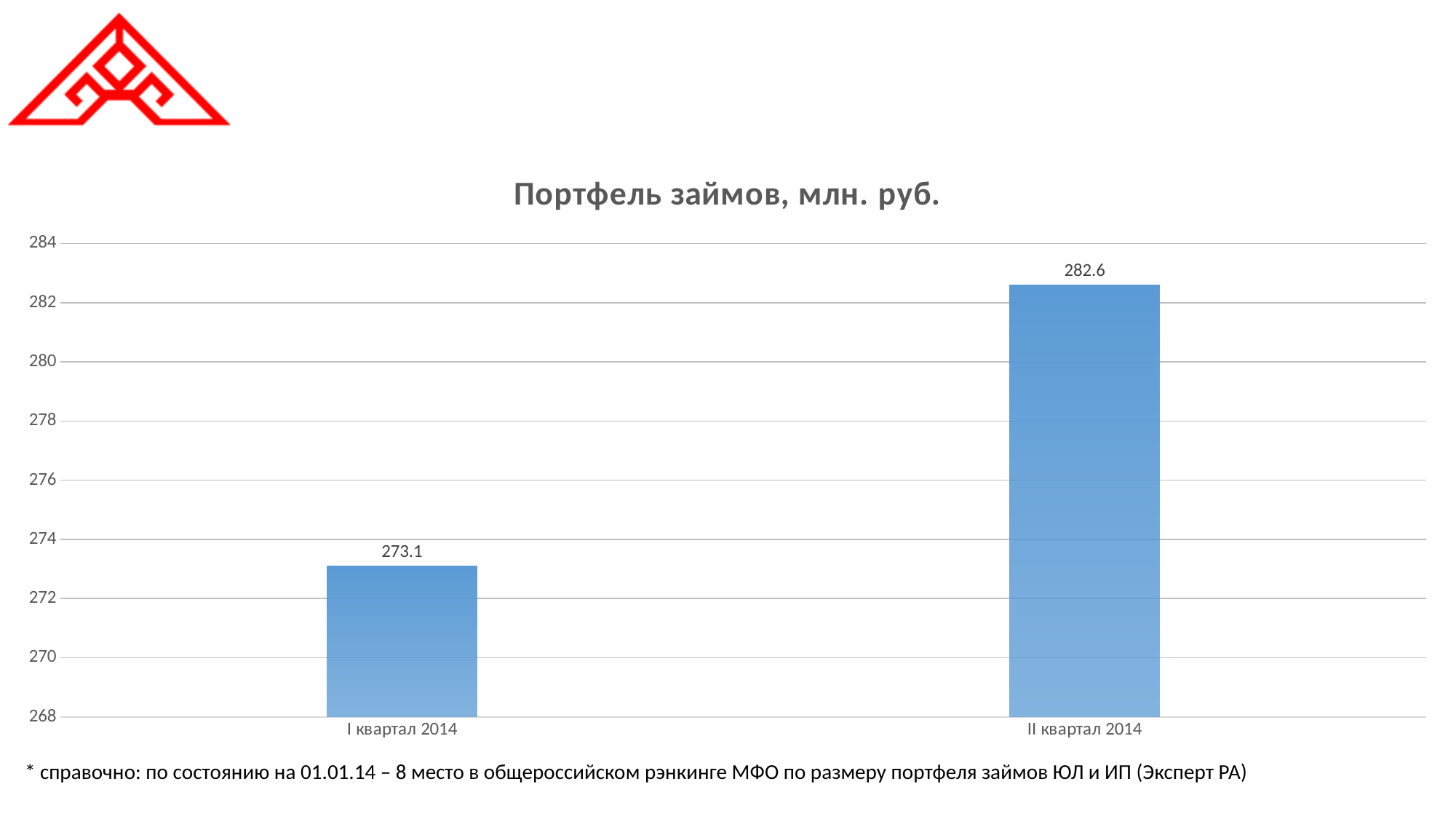
Which quarter has the highest loan portfolio value? II квартал 2014 Is the value for II квартал 2014 greater or less than 280? greater What is the title of the chart? Портфель займов, млн. руб. Which quarter has the lowest loan portfolio value? I квартал 2014 What is the difference between the values for II квартал 2014 and I квартал 2014? 9.5 How many categories are shown on the x axis? 2 Which is larger, the value for I квартал 2014 or II квартал 2014? II квартал 2014 Do the values rise or fall from I квартал 2014 to II квартал 2014? rise What is the value for II квартал 2014? 282.6 Is the value for I квартал 2014 greater or less than 274? less What is the value for I квартал 2014? 273.1 What kind of chart is shown on the slide? bar chart